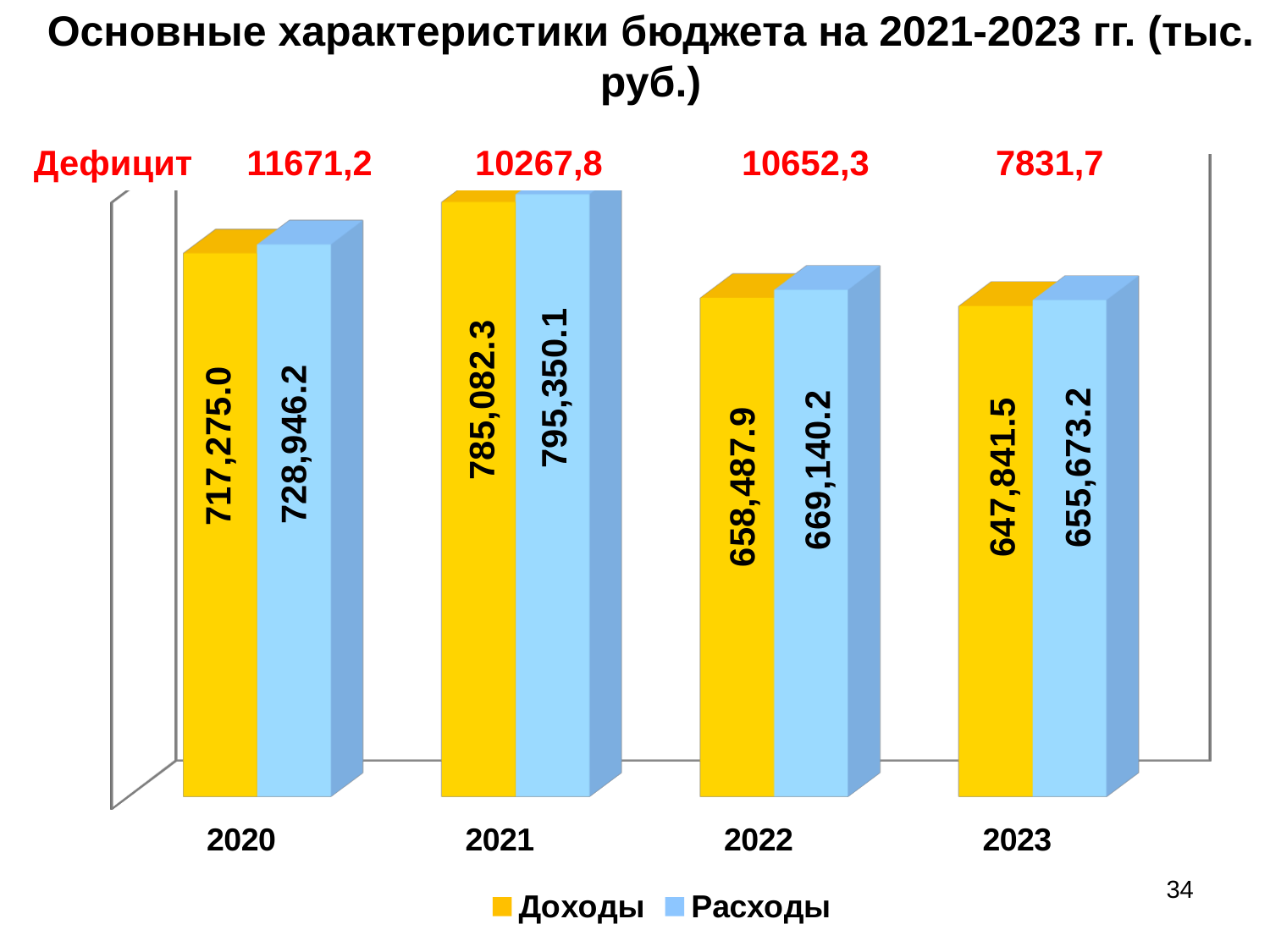
What is the value of Расходы for 2023? 655,673.2 How many series does the legend list? 2 How many years are shown on the x axis? 4 What is the value of Доходы for 2022? 658,487.9 What is the difference between Доходы in 2021 and Доходы in 2020? 67,807.3 Which year has the highest value of Расходы? 2021 What is the value of Доходы for 2021? 785,082.3 What is the value of Расходы for 2020? 728,946.2 Which year has the lowest value of Доходы? 2023 What kind of chart is shown on the slide? Bar chart Which is larger in 2022: Доходы or Расходы? Расходы What is the difference between Расходы and Доходы in 2021? 10,267.8